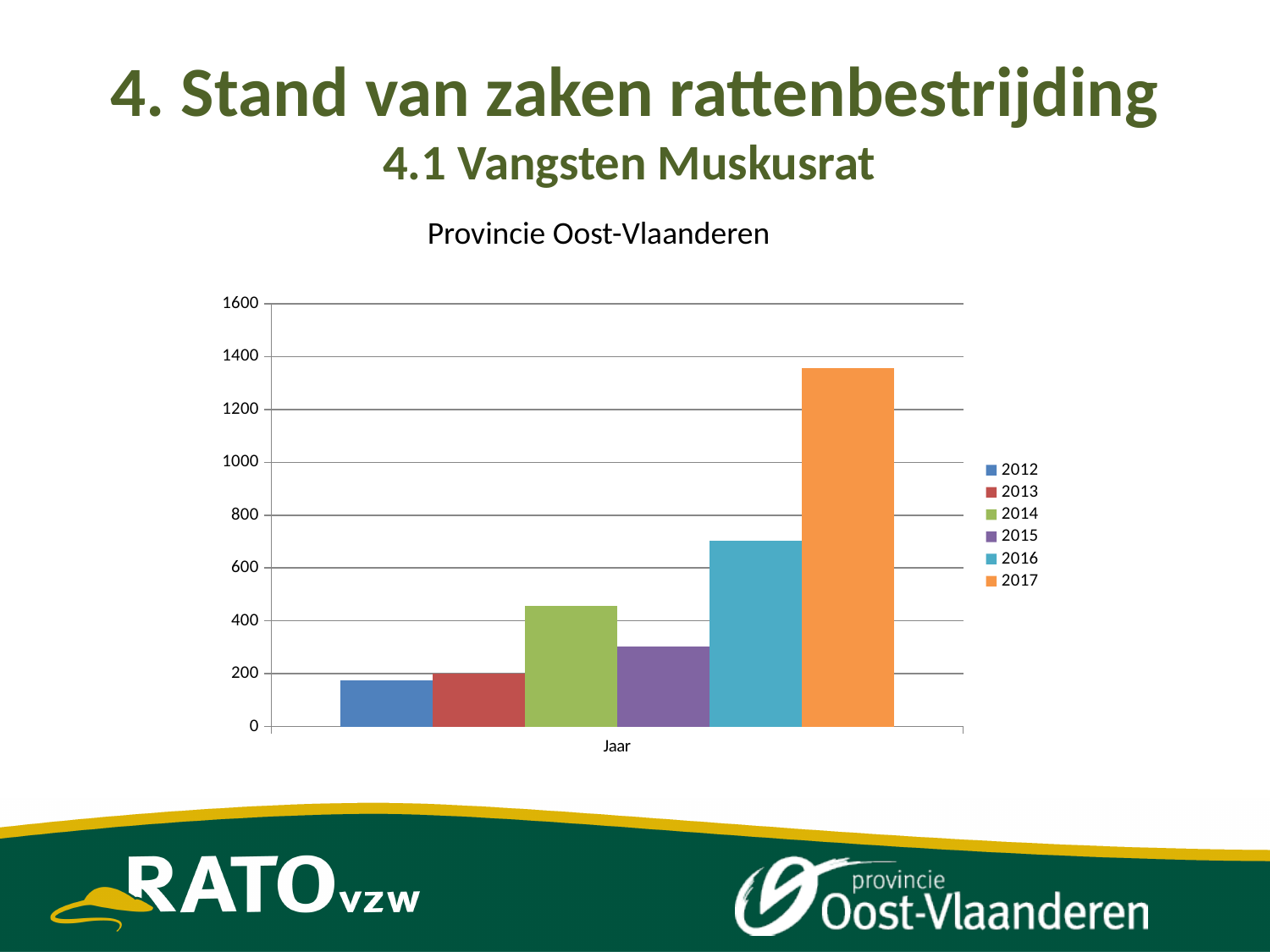
Which year has the highest value? 2017 What is the title of the chart? Provincie Oost-Vlaanderen Which year has the lowest value? 2012 Is the value for 2017 greater or less than 1200? greater What is the label on the horizontal axis? Jaar Is the value for 2014 greater or less than 400? greater Is the value for 2015 greater or less than 400? less What kind of chart is shown on the slide? bar chart Which is larger, the value for 2016 or the value for 2014? 2016 Which is larger, the value for 2014 or the value for 2015? 2014 How many series does the legend list? 6